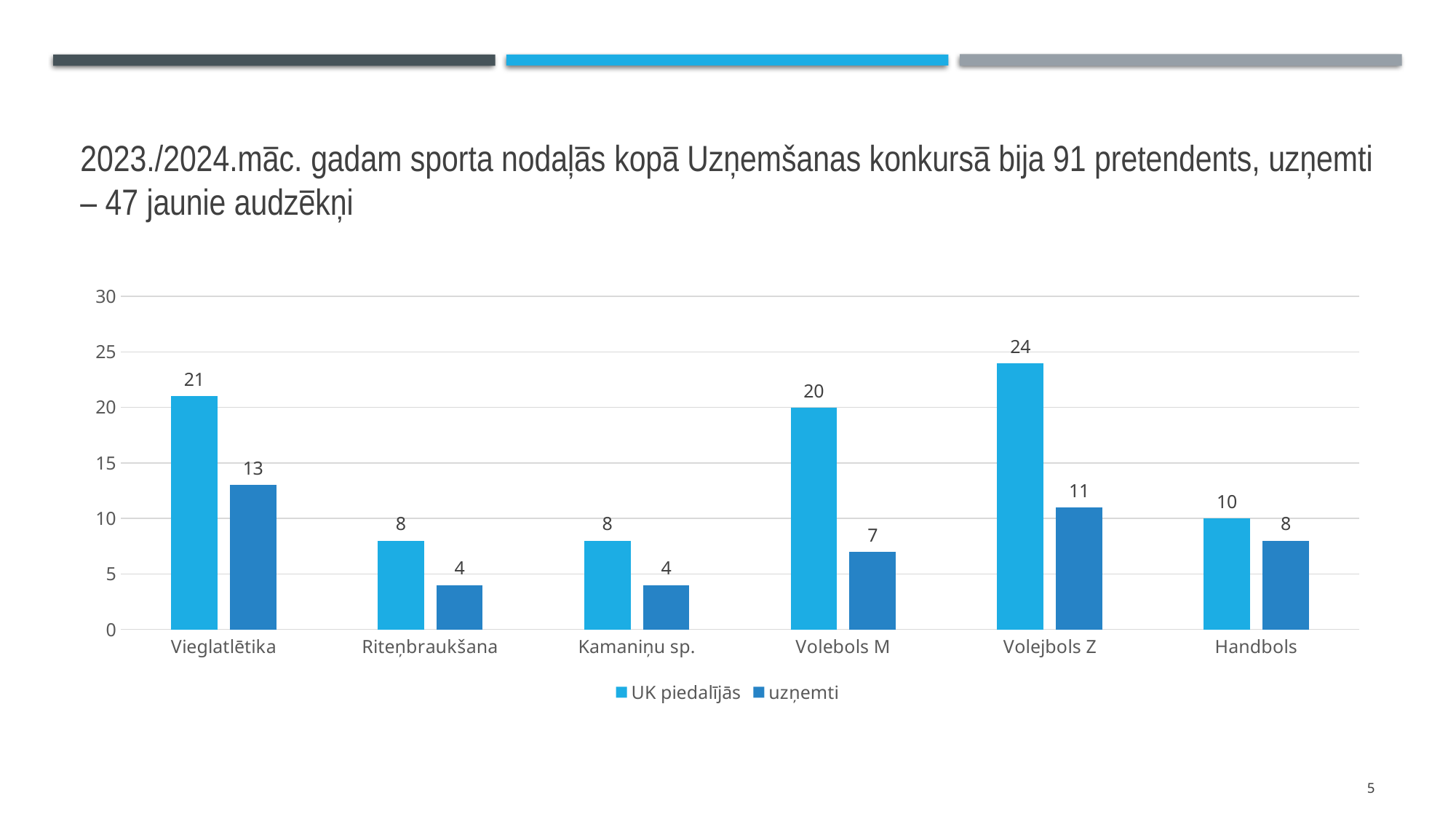
What is the difference between "UK piedalījās" and "uzņemti" for Volejbols Z? 13 What is the difference between "UK piedalījās" and "uzņemti" for Handbols? 2 What kind of chart is shown on the slide? Bar chart How many series does the legend list? 2 Which category has the lowest "uzņemti" value? Riteņbraukšana and Kamaniņu sp. What are the two series listed in the legend? UK piedalījās and uzņemti What is the value of "UK piedalījās" for Vieglatlētika? 21 What is the value of "uzņemti" for Volejbols Z? 11 Which is larger: "UK piedalījās" for Vieglatlētika or "UK piedalījās" for Volebols M? Vieglatlētika Which category has the highest "UK piedalījās" value? Volejbols Z What is the value of "uzņemti" for Volebols M? 7 How many categories are shown on the x axis? 6